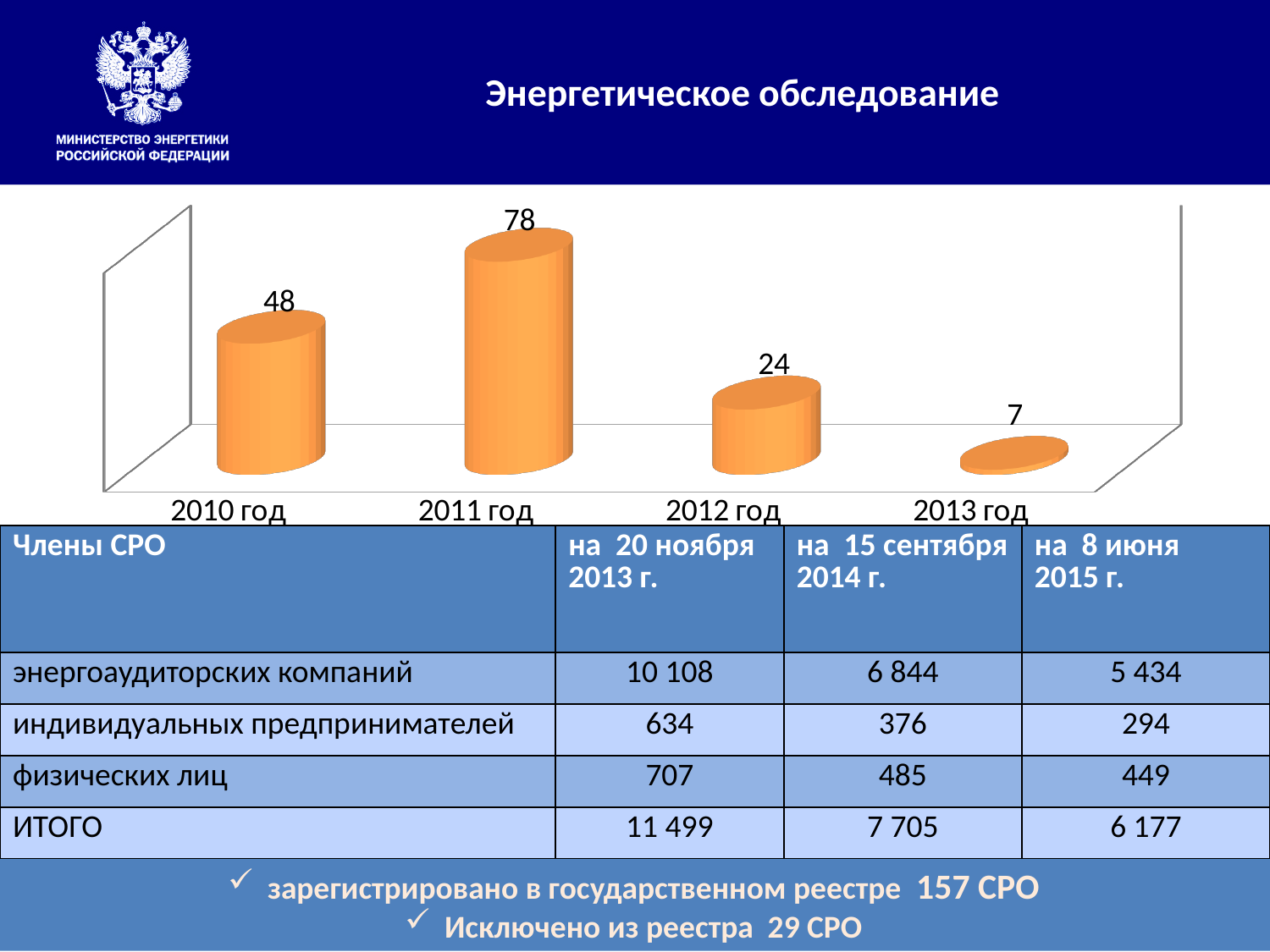
Which year has the lowest value? 2013 год Which year has the highest value? 2011 год Which is larger, the value for 2010 год or the value for 2012 год? 2010 год What is the value for 2012 год? 24 What is the difference between the values for 2012 год and 2013 год? 17 What is the value for 2010 год? 48 What is the difference between the values for 2011 год and 2010 год? 30 What kind of chart is shown on the slide? bar chart What is the value for 2011 год? 78 Do the values rise or fall from 2011 год to 2013 год? fall What is the value for 2013 год? 7 How many years are shown in the chart? 4